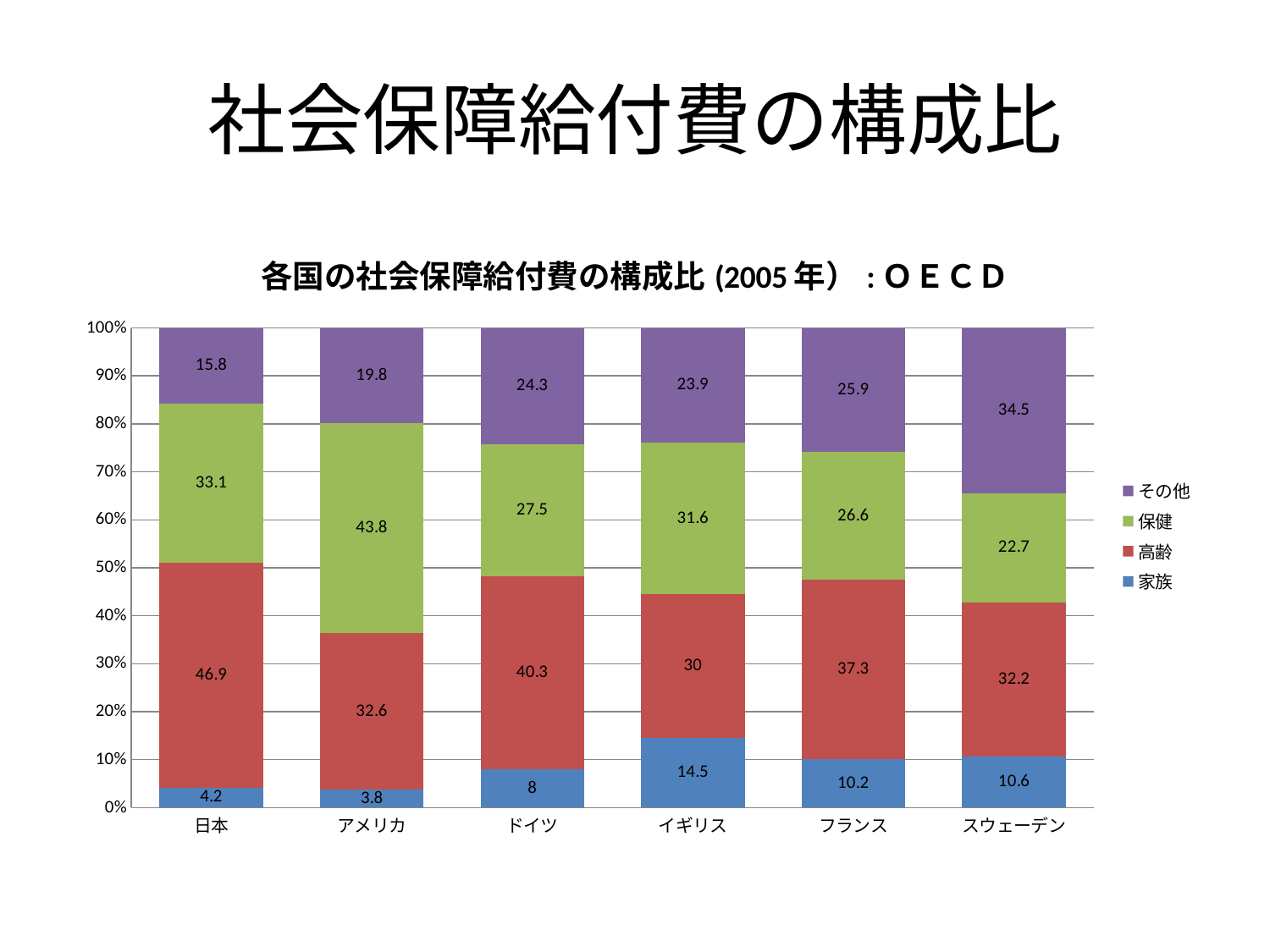
What is the value of その他 for スウェーデン? 34.5 What is the value of 家族 for イギリス? 14.5 What is the value of 保健 for アメリカ? 43.8 How many series does the legend list? 4 Which is larger, the 保健 value for ドイツ or the 保健 value for フランス? ドイツ What is the value of 高齢 for 日本? 46.9 Which country has the lowest value for 保健? スウェーデン What kind of chart is shown? Stacked bar chart How many countries are shown on the x axis? 6 What is the difference between the 高齢 values for 日本 and アメリカ? 14.3 Which country has the lowest value for その他? 日本 Which country has the highest value for 家族? イギリス